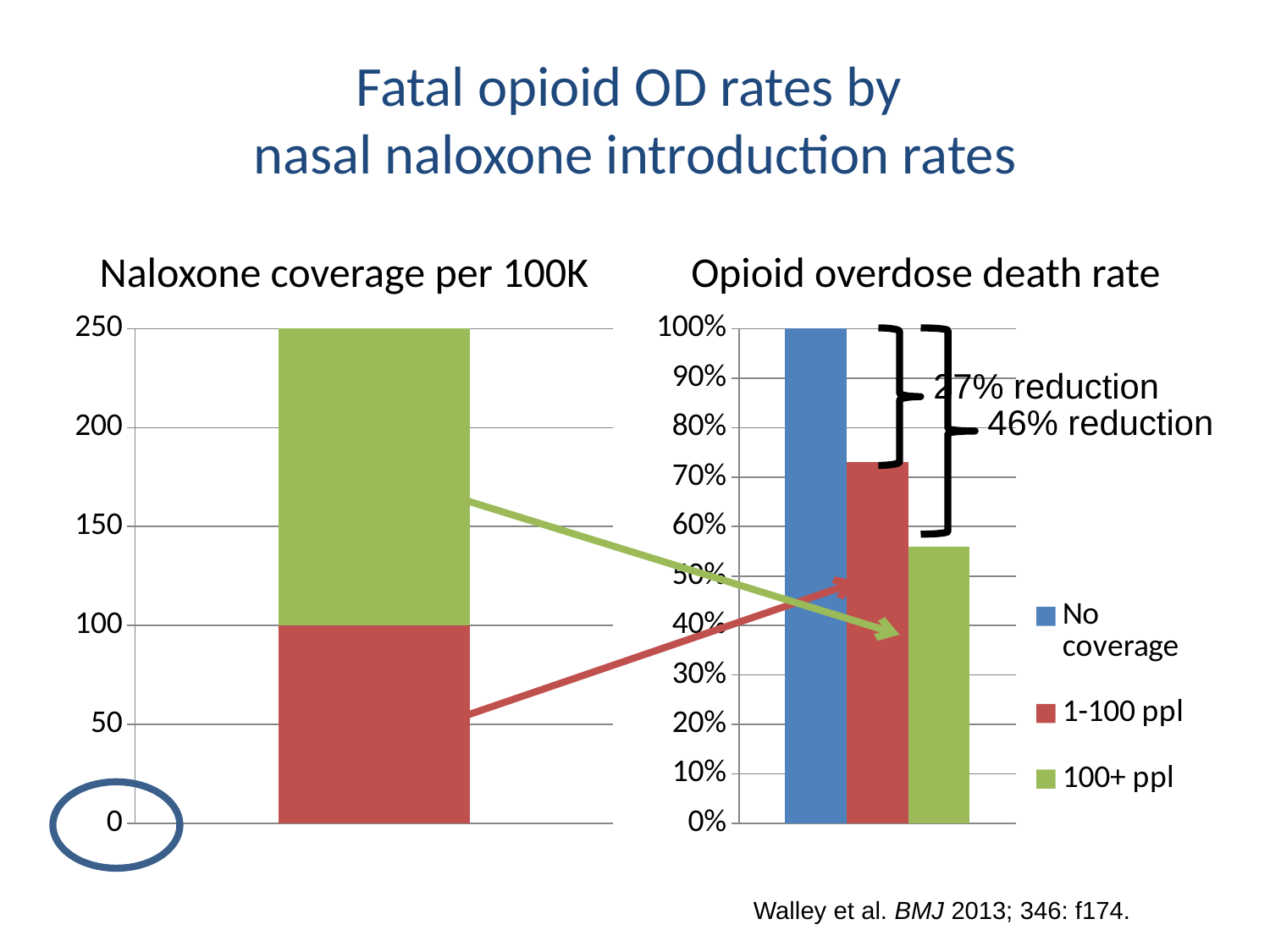
According to the annotation on the 'Opioid overdose death rate' chart, what reduction is shown for the 100+ ppl bar? 46% reduction In the 'Opioid overdose death rate' chart, is the value for 100+ ppl greater or less than 60%? less In the 'Opioid overdose death rate' chart, which is larger, the value for 1-100 ppl or the value for 100+ ppl? 1-100 ppl In the 'Opioid overdose death rate' chart, which category has the lowest value? 100+ ppl In the 'Opioid overdose death rate' chart, do the values rise or fall from left to right? fall In the 'Opioid overdose death rate' chart, is the value for 1-100 ppl greater or less than 80%? less In the 'Opioid overdose death rate' chart, how many bars are plotted? 3 How many series does the legend list? 3 In the 'Opioid overdose death rate' chart, which category has the highest value? No coverage What kind of chart is the 'Opioid overdose death rate' chart? bar chart In the 'Opioid overdose death rate' chart, what is the value for No coverage? 100% In the 'Naloxone coverage per 100K' chart, what is the total height of the stacked bar? 250